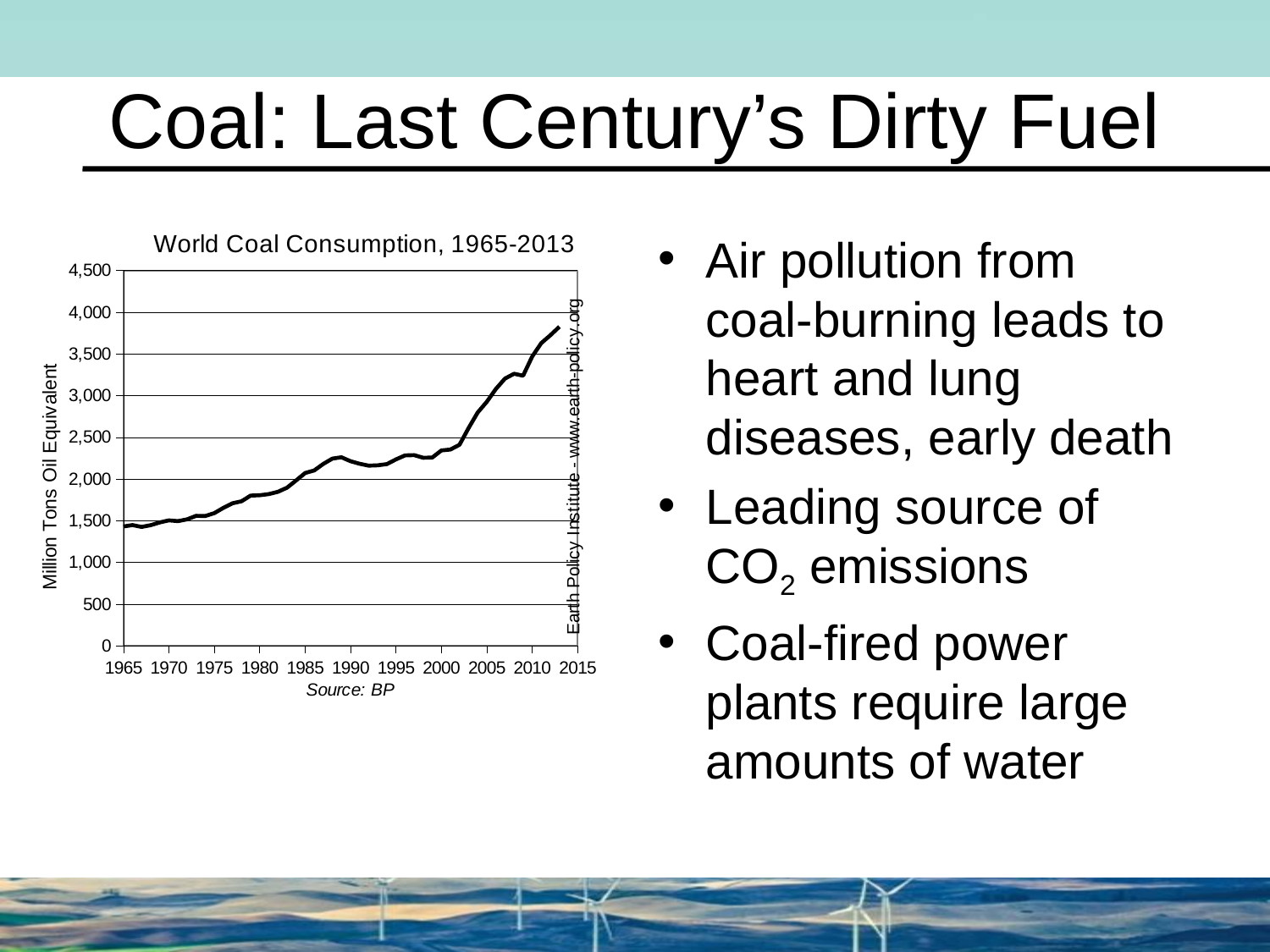
Is the value for 2000 greater or less than 2,500? less Does world coal consumption generally rise or fall from 1965 to 2013? rise Which is larger, the value for 1975 or the value for 2005? 2005 Is the value for 2010 greater or less than 3,000? greater Is the value for 1980 greater or less than 2,000? less What is the title of the chart? World Coal Consumption, 1965-2013 Which year has the highest world coal consumption on the chart? 2013 What unit is shown on the vertical axis of the chart? Million Tons Oil Equivalent What kind of chart is shown on the slide? line chart